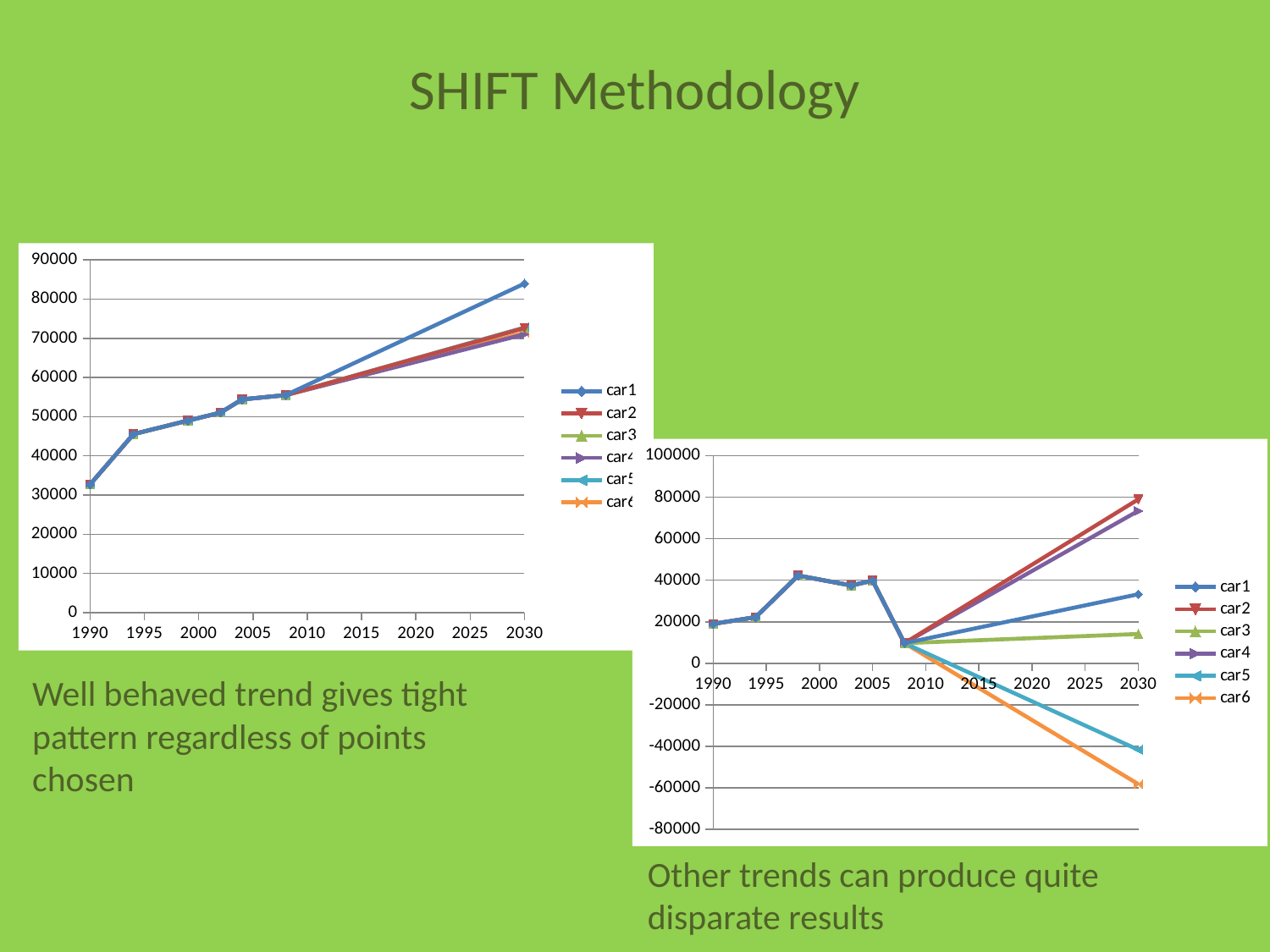
In the right chart, is the value for car3 at 2030 greater or less than 20000? less In the left chart, do the values generally rise or fall from 1990 to 2030? rise In the left chart, which series has the highest value at 2030? car1 What kind of chart is the chart on the left of the slide? line chart In the left chart, is the value for car1 at 2030 greater or less than 80000? greater In the right chart, which is larger at 2030, car1 or car3? car1 In the right chart, which series has the highest value at 2030? car2 In the right chart, is the value for car6 at 2030 greater or less than -40000? less How many series does the legend of the left chart list? 6 What is the last series listed in the legend of the right chart? car6 In the right chart, which series has the lowest value at 2030? car6